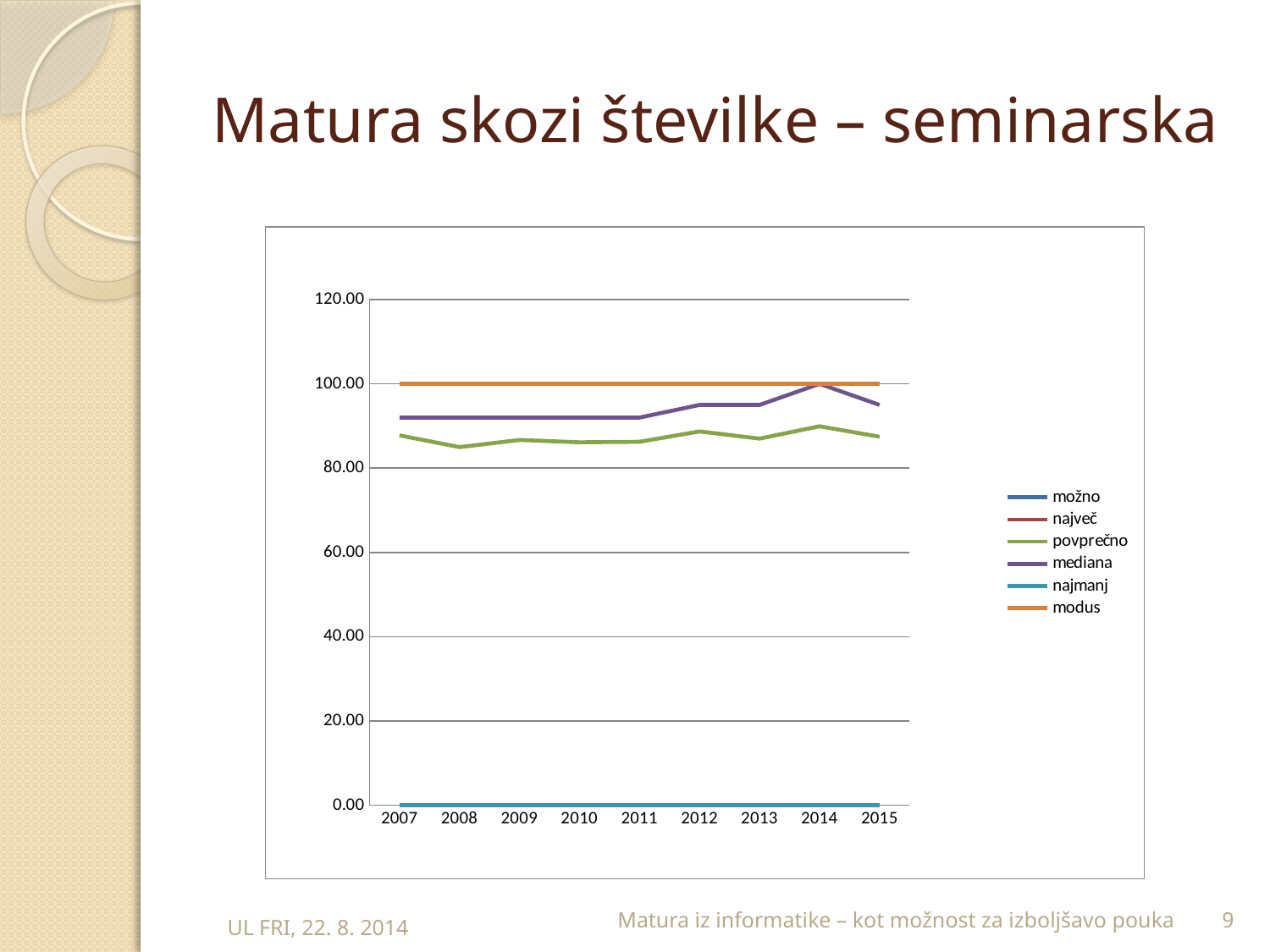
In which year does the mediana series reach its highest value? 2014 Does the mediana series rise or fall from 2011 to 2014? rise How many years are shown on the x axis? 9 In 2015, which is larger: modus or povprečno? modus What is the value of the najmanj series in 2012? 0.00 Is the value for povprečno in 2008 greater or less than 80? greater How many series does the legend list? 6 What kind of chart is shown on the slide? line chart Is the value for mediana in 2007 greater or less than 100? less In 2012, which is larger: mediana or povprečno? mediana What colour is the modus series in the legend? orange What is the value of the modus series in 2010? 100.00